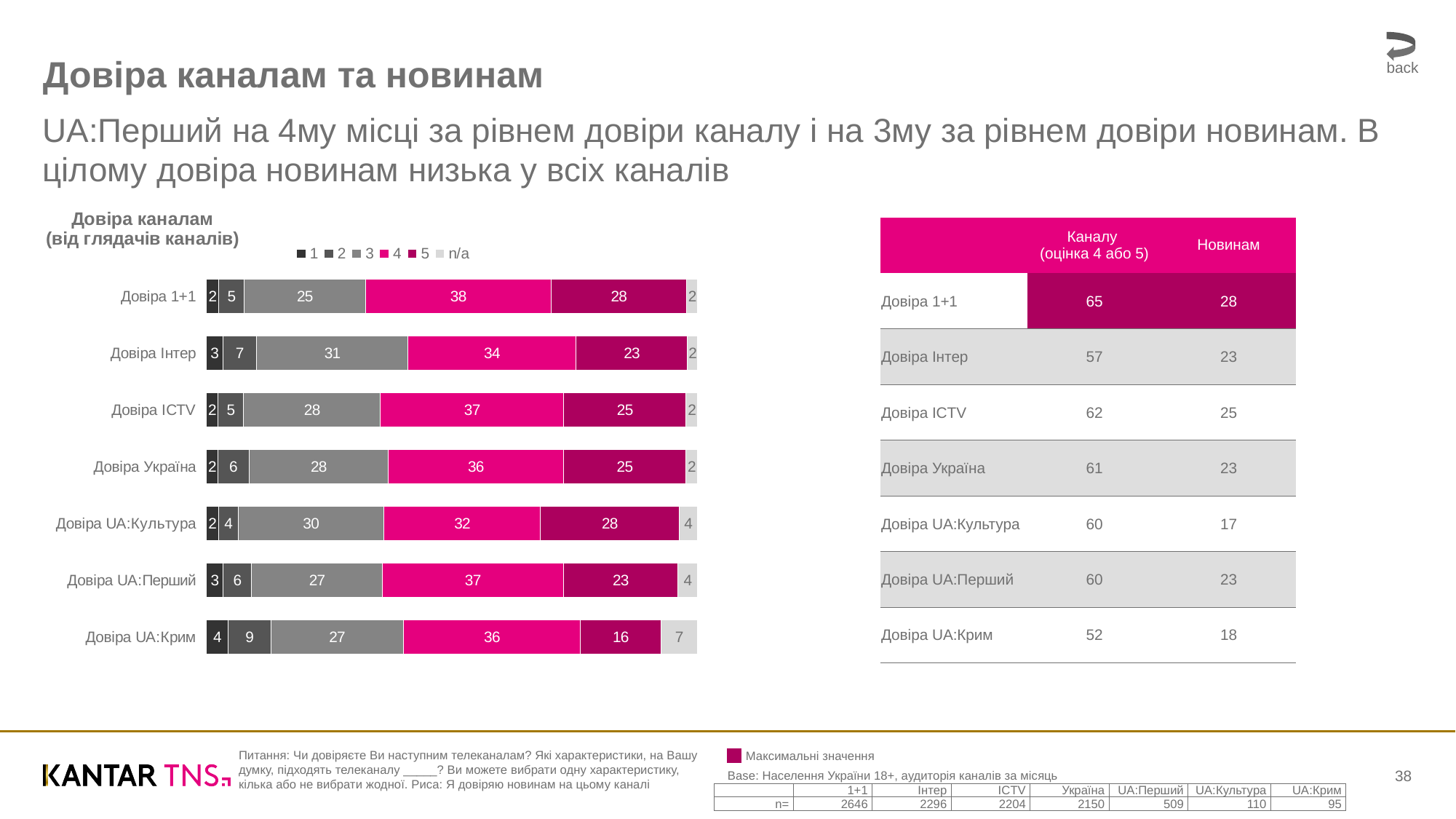
How many channel categories are plotted in the chart? 7 Which category has the lowest value for series 5? Довіра UA:Крим What is the value of series 3 for Довіра Інтер? 31 Which category has the highest n/a value? Довіра UA:Крим What is the n/a value for Довіра UA:Перший? 4 How many series does the chart legend list? 6 What is the total of the stacked bar for Довіра 1+1? 100 Which has the larger series 2 value, Довіра UA:Крим or Довіра 1+1? Довіра UA:Крим What is the value of series 5 for Довіра UA:Крим? 16 What is the difference between the series 4 values for Довіра 1+1 and Довіра Інтер? 4 What kind of chart is shown on the slide? bar chart What is the value of series 4 for Довіра 1+1? 38